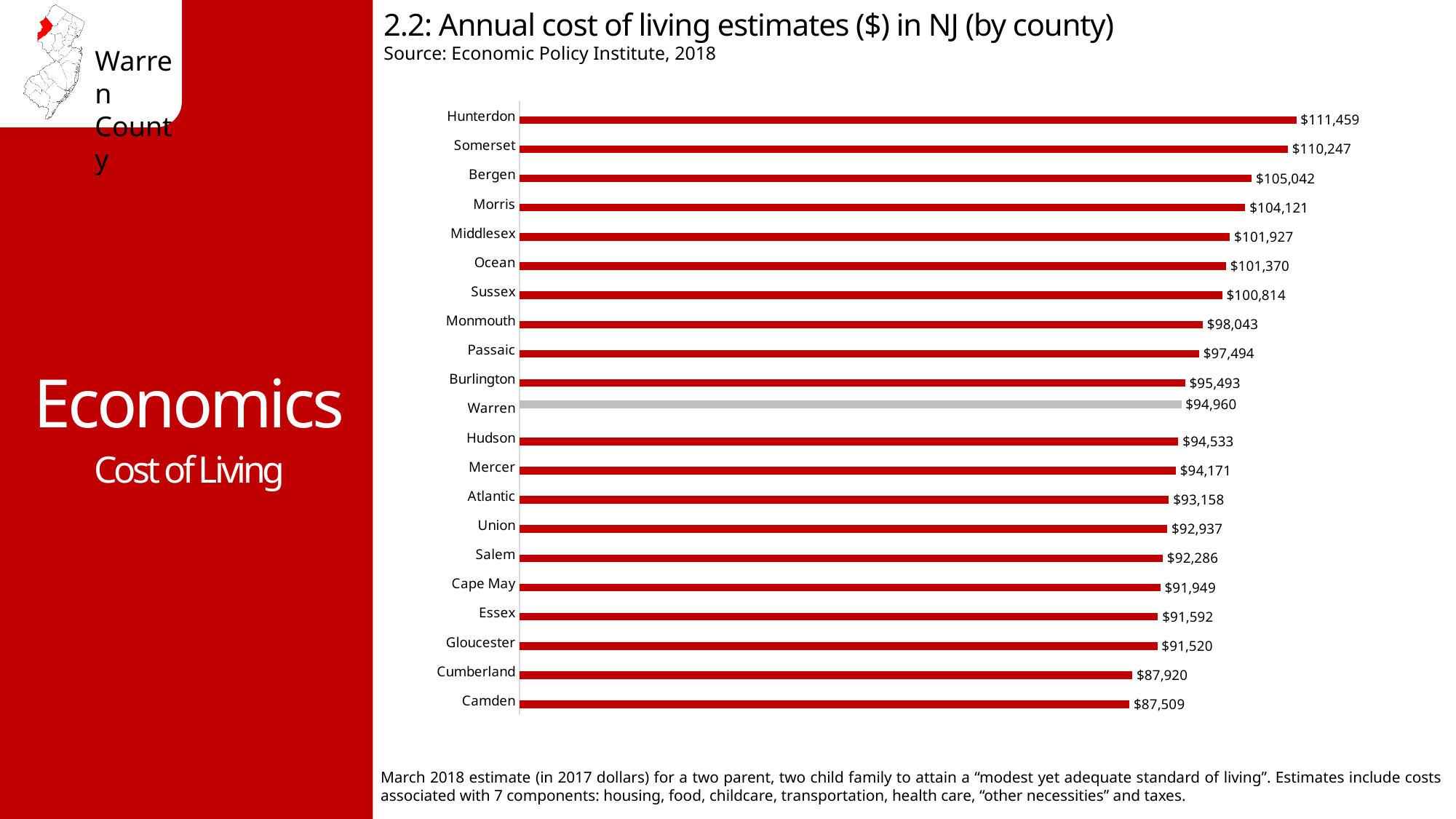
What is the annual cost of living estimate for Ocean County? $101,370 What is the difference between the cost of living estimates for Hunterdon and Camden? $23,950 Which county has the lowest annual cost of living estimate? Camden Which county has a higher cost of living estimate, Cumberland or Gloucester? Gloucester Which county has a higher cost of living estimate, Bergen or Morris? Bergen What is the difference between the cost of living estimates for Warren and Hudson? $427 How many counties are shown in the chart? 21 What is the annual cost of living estimate for Warren County? $94,960 What is the annual cost of living estimate for Hunterdon County? $111,459 Which county has the highest annual cost of living estimate? Hunterdon Which county's bar is shown in grey instead of red? Warren What kind of chart is shown on the slide? Bar chart